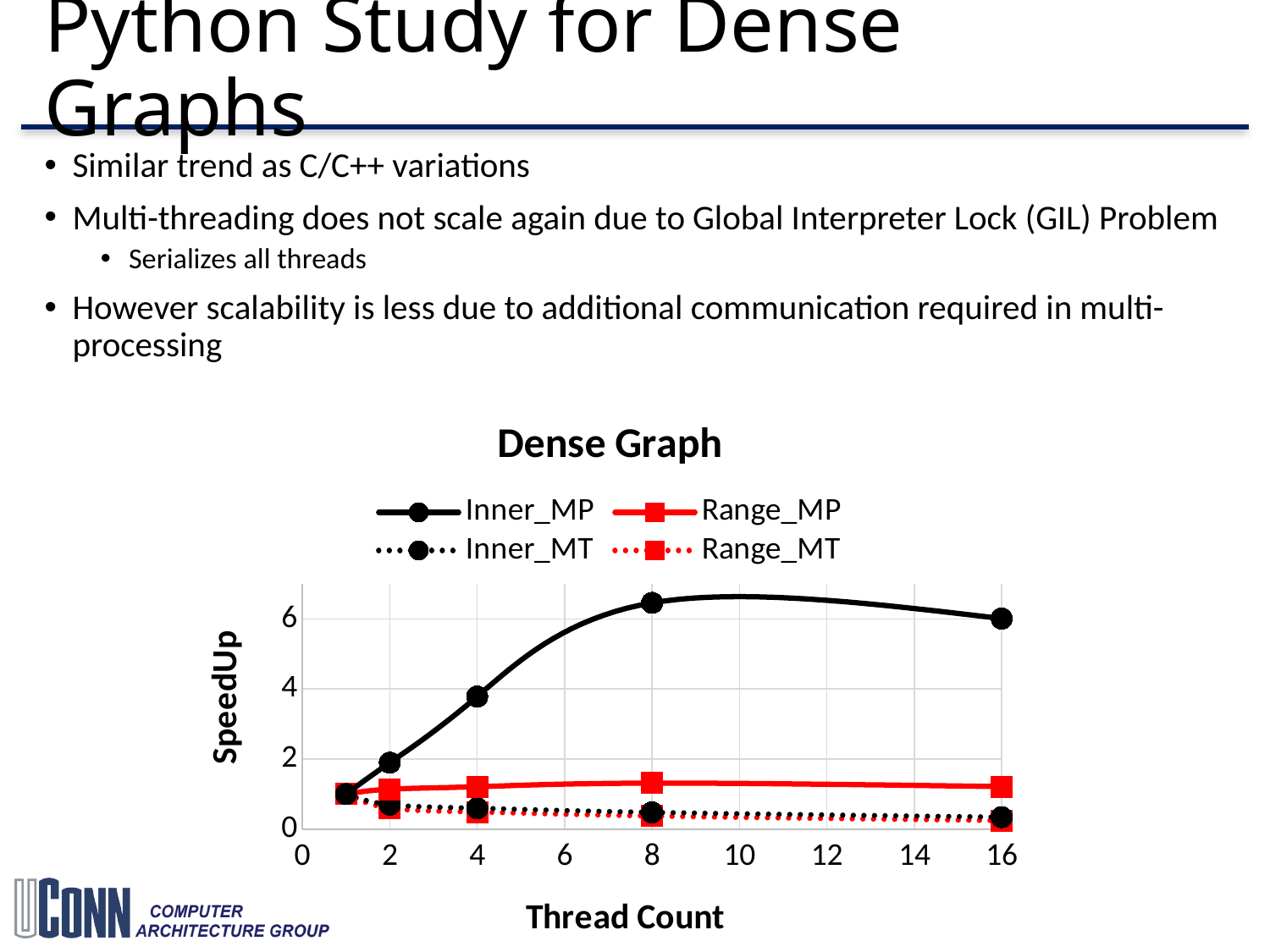
Is the value for Inner_MT at a thread count of 16 greater or less than 1? less Is the value for Inner_MP at a thread count of 4 greater or less than 4? less Which series has the highest speedup at a thread count of 8? Inner_MP What is the label of the y axis of the chart? SpeedUp At a thread count of 16, which is larger: Inner_MP or Range_MP? Inner_MP Does the Inner_MT series rise or fall as the thread count increases from 1 to 16? fall What kind of chart is shown on the slide? line chart Is the value for Range_MP at a thread count of 8 greater or less than 2? less What is the title of the chart? Dense Graph How many series does the legend of the Dense Graph chart list? 4 How many data points are plotted for the Inner_MP series? 5